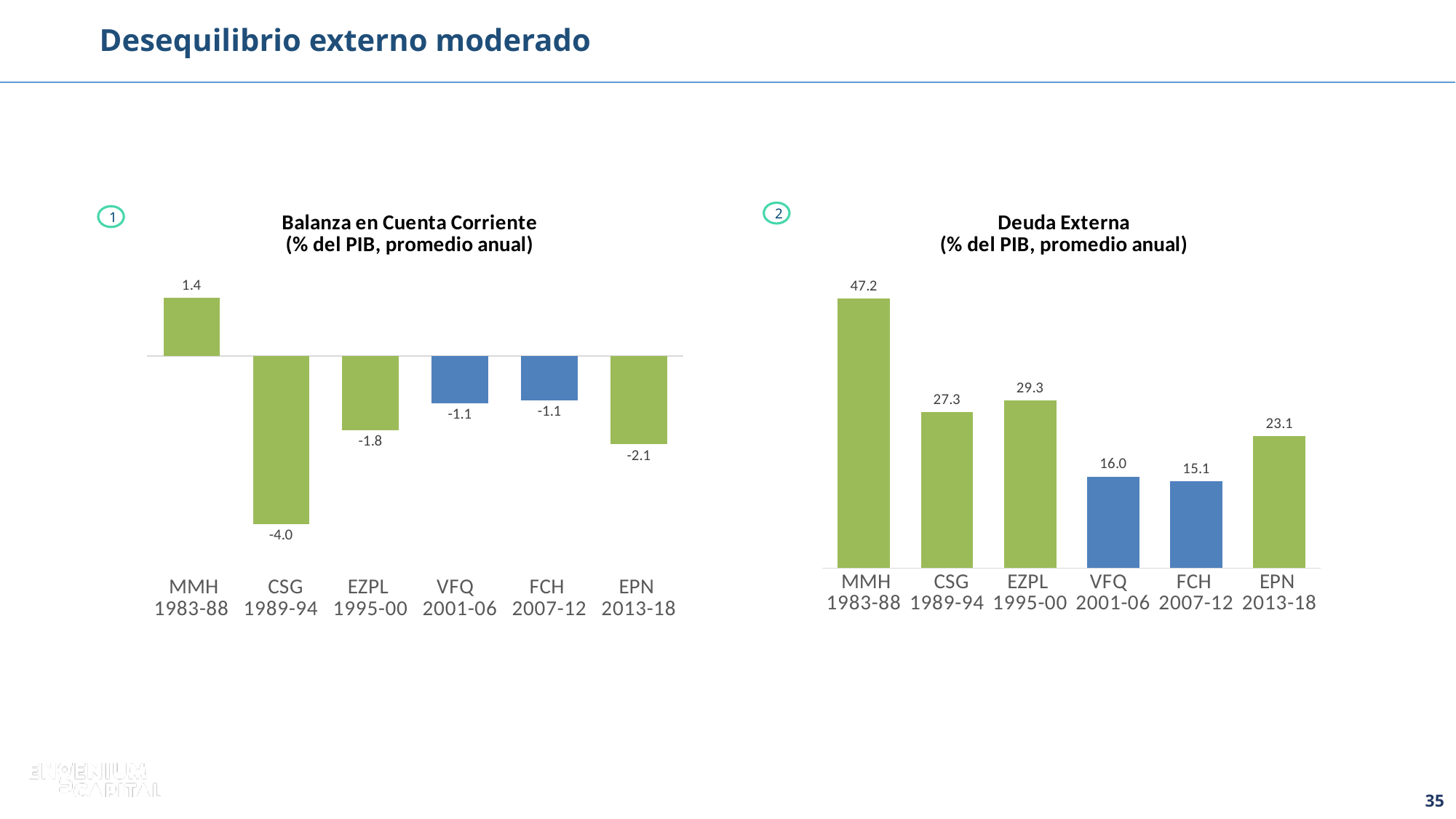
In the 'Deuda Externa' chart, what is the value for EPN 2013-18? 23.1 In the 'Balanza en Cuenta Corriente' chart, which period has the highest value? MMH 1983-88 In the 'Deuda Externa' chart, what is the value for MMH 1983-88? 47.2 What kind of chart is the 'Deuda Externa' chart? Bar chart In the 'Balanza en Cuenta Corriente' chart, what is the value for MMH 1983-88? 1.4 In the 'Balanza en Cuenta Corriente' chart, how many periods are shown? 6 In the 'Balanza en Cuenta Corriente' chart, which period has the lowest value? CSG 1989-94 In the 'Deuda Externa' chart, which period has the lowest value? FCH 2007-12 In the 'Deuda Externa' chart, what is the difference between the values for MMH 1983-88 and CSG 1989-94? 19.9 In the 'Deuda Externa' chart, which is larger, the value for EZPL 1995-00 or the value for EPN 2013-18? EZPL 1995-00 In the 'Balanza en Cuenta Corriente' chart, what is the value for CSG 1989-94? -4.0 In the 'Balanza en Cuenta Corriente' chart, what is the difference between the values for EZPL 1995-00 and EPN 2013-18? 0.3